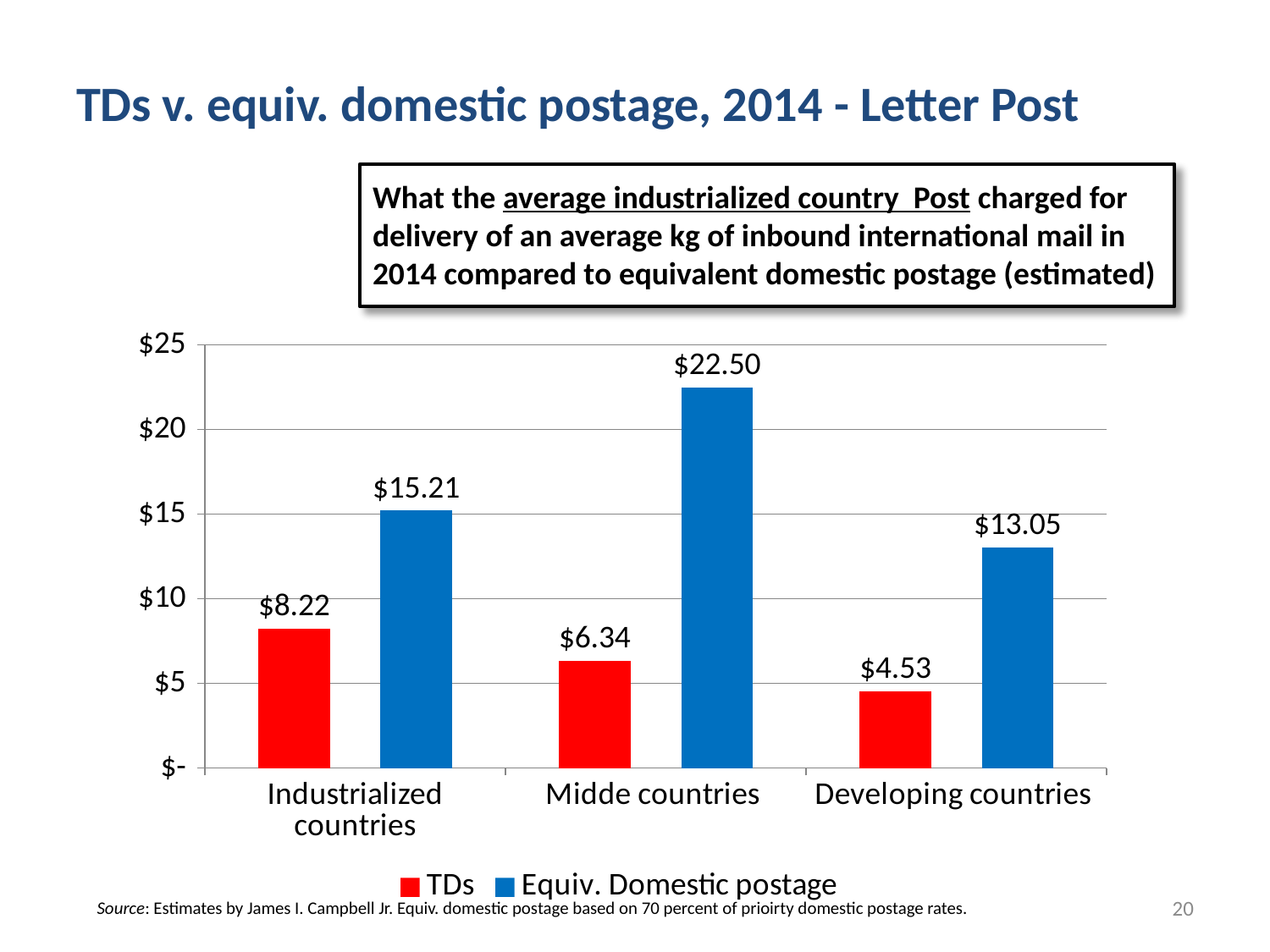
What colour are the TDs bars? Red What is the TDs value for Industrialized countries? $8.22 How many categories are shown on the x axis? 3 What is the Equiv. Domestic postage value for Developing countries? $13.05 Which category has the highest Equiv. Domestic postage value? Midde countries What is the TDs value for Developing countries? $4.53 Which is larger for Midde countries, TDs or Equiv. Domestic postage? Equiv. Domestic postage Which category has the lowest TDs value? Developing countries What is the Equiv. Domestic postage value for Midde countries? $22.50 What is the difference between the Equiv. Domestic postage and TDs values for Industrialized countries? $6.99 What kind of chart is shown on the slide? Bar chart How many series does the legend list? 2